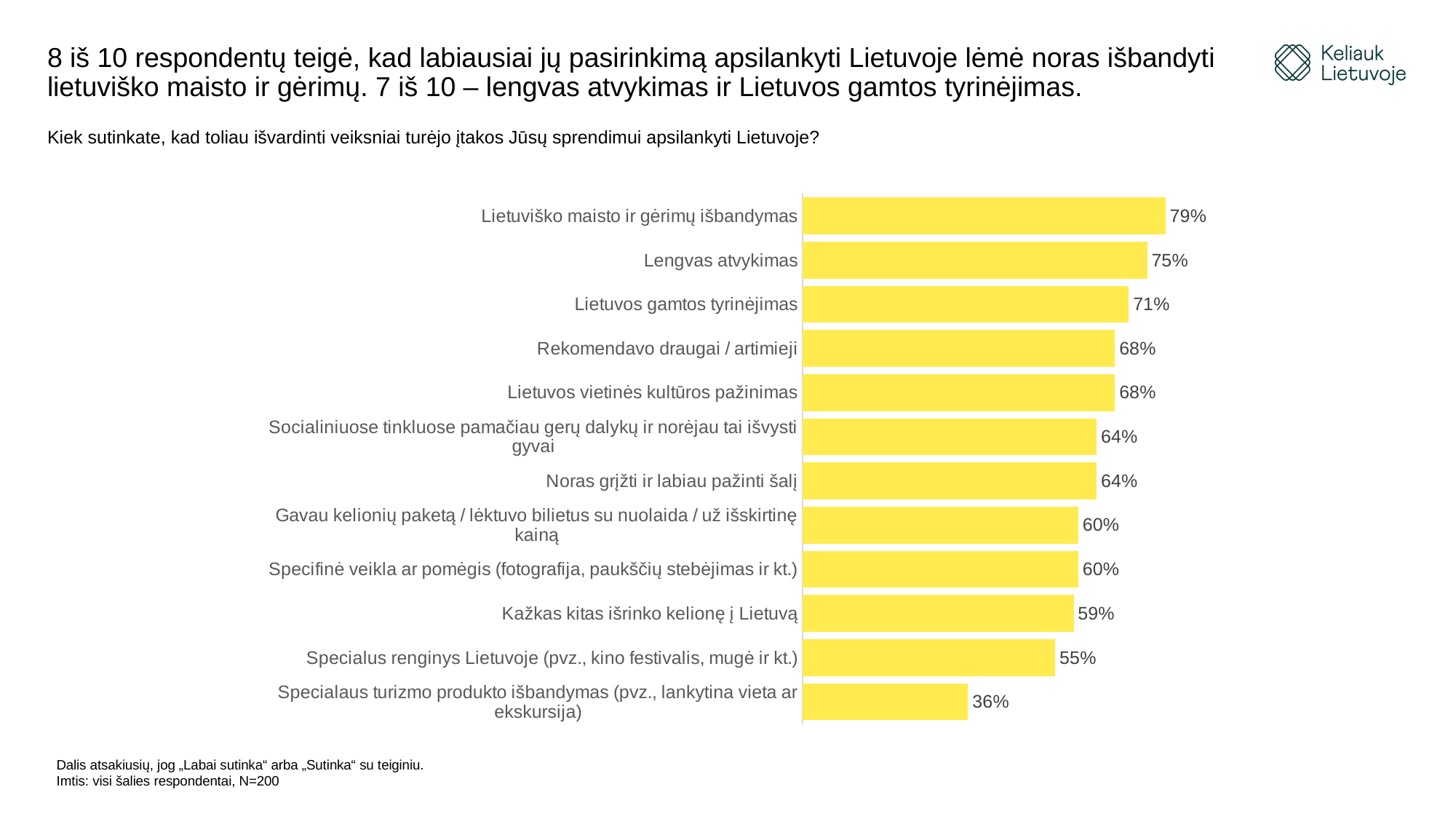
What is the difference between the values for "Lietuviško maisto ir gėrimų išbandymas" and "Lietuvos gamtos tyrinėjimas"? 8% What is the value for "Lengvas atvykimas"? 75% What is the value for "Lietuviško maisto ir gėrimų išbandymas"? 79% What is the value for "Specialus renginys Lietuvoje (pvz., kino festivalis, mugė ir kt.)"? 55% Which category has the lowest value? Specialaus turizmo produkto išbandymas (pvz., lankytina vieta ar ekskursija) What colour are the bars in the chart? Yellow How many categories are shown in the chart? 12 What is the difference between the values for "Lengvas atvykimas" and "Specialaus turizmo produkto išbandymas (pvz., lankytina vieta ar ekskursija)"? 39% What kind of chart is shown on the slide? Bar chart Which category has the highest value? Lietuviško maisto ir gėrimų išbandymas Which is larger: the value for "Lengvas atvykimas" or the value for "Rekomendavo draugai / artimieji"? Lengvas atvykimas What is the value for "Kažkas kitas išrinko kelionę į Lietuvą"? 59%